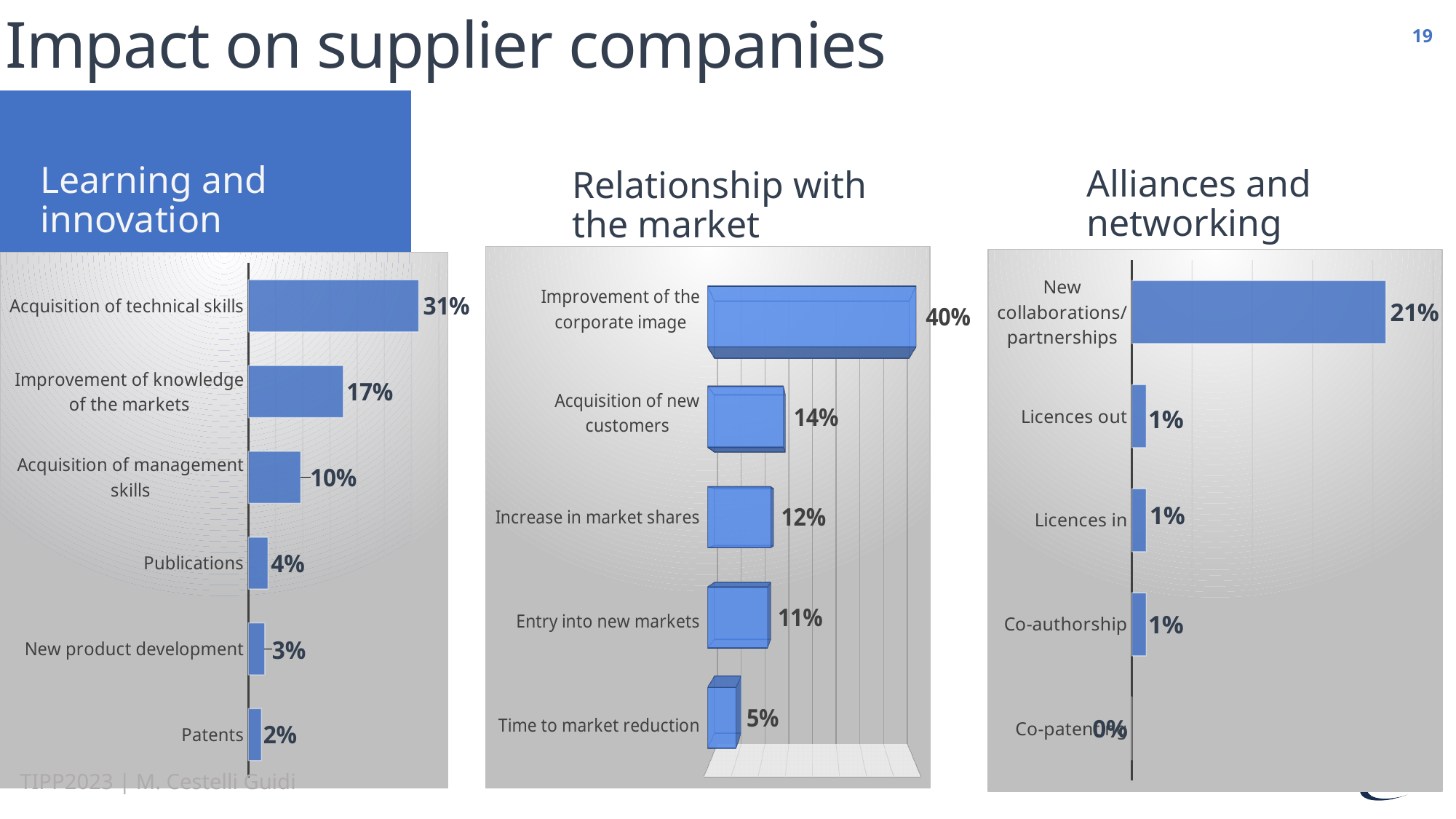
In the 'Relationship with the market' chart, which category has the highest value? Improvement of the corporate image In the 'Learning and innovation' chart, what is the value for Acquisition of technical skills? 31% What kind of chart is the 'Learning and innovation' chart? Bar chart In the 'Relationship with the market' chart, what is the value for Time to market reduction? 5% In the 'Learning and innovation' chart, what is the difference between Improvement of knowledge of the markets and Acquisition of management skills? 7% In the 'Learning and innovation' chart, how many categories are shown? 6 In the 'Relationship with the market' chart, what is the value for Improvement of the corporate image? 40% In the 'Alliances and networking' chart, what is the value for New collaborations/partnerships? 21% In the 'Relationship with the market' chart, which is larger: Acquisition of new customers or Increase in market shares? Acquisition of new customers In the 'Learning and innovation' chart, which category has the lowest value? Patents In the 'Alliances and networking' chart, how many categories are shown? 5 In the 'Alliances and networking' chart, what is the value for Licences out? 1%